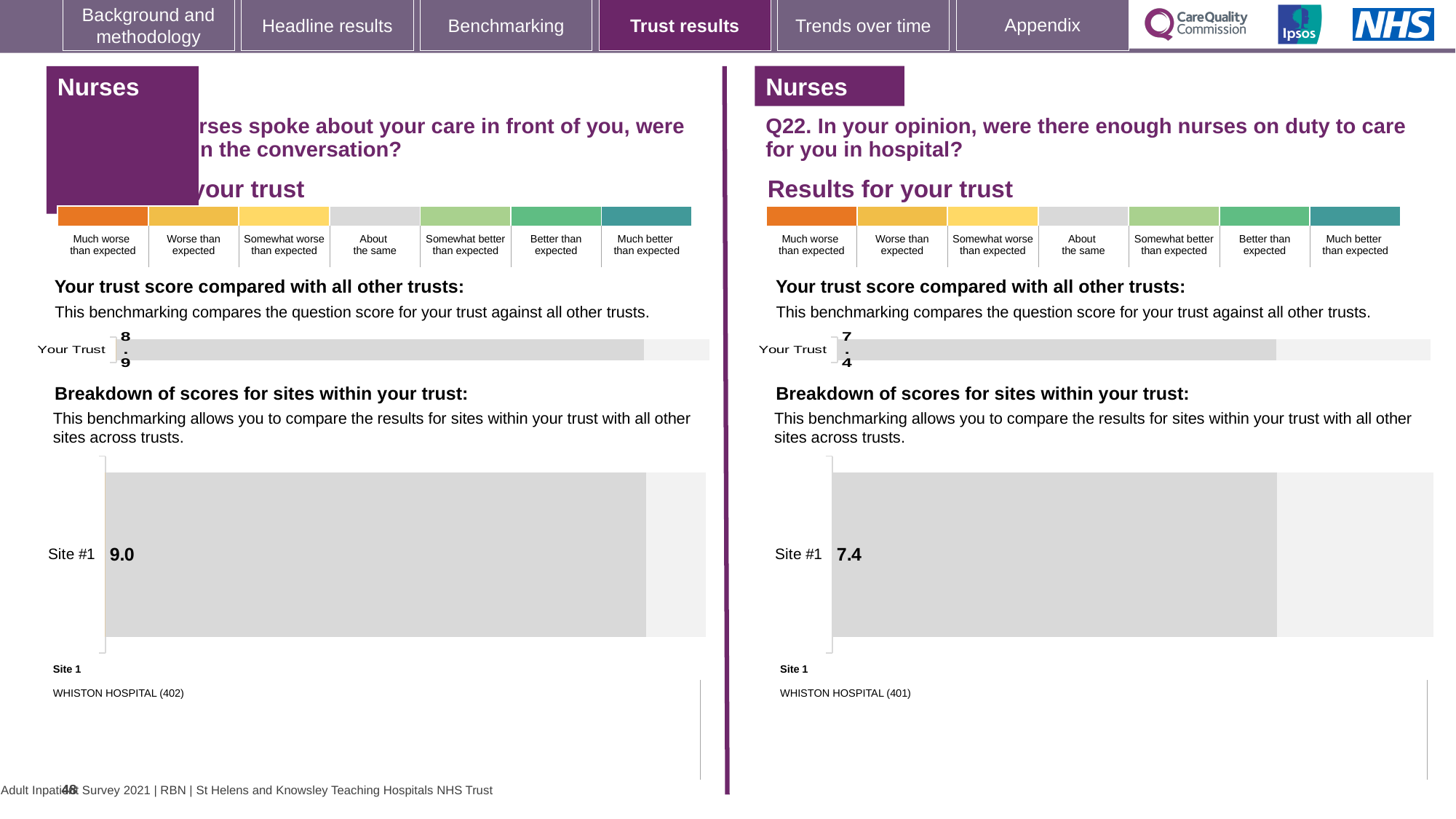
What type of chart is used to show the Site #1 score in the left breakdown chart? Bar chart Which hospital is listed as Site 1 under the right (Q22) breakdown chart? WHISTON HOSPITAL (401) In the right (Q22) 'Breakdown of scores for sites within your trust' chart, what is the score for Site #1? 7.4 Which hospital is listed as Site 1 under the left breakdown chart? WHISTON HOSPITAL (402) What is the difference between the Site #1 score in the left breakdown chart (9.0) and the Site #1 score in the right (Q22) breakdown chart (7.4)? 1.6 Which is larger: the Site #1 score in the left breakdown chart or the Site #1 score in the right (Q22) breakdown chart? The left chart (9.0) On the left half of the slide, what is the score shown for Your Trust in the 'Your trust score compared with all other trusts' chart? 8.9 On the right half of the slide (Q22), what is the score shown for Your Trust in the 'Your trust score compared with all other trusts' chart? 7.4 What is the difference between the Your Trust score on the left (8.9) and the Your Trust score on the right for Q22 (7.4)? 1.5 Is the Your Trust score on the left half of the slide greater or less than the Your Trust score for Q22 on the right? greater How many sites are shown in the right (Q22) 'Breakdown of scores for sites within your trust' chart? 1 In the left 'Breakdown of scores for sites within your trust' chart, what is the score for Site #1? 9.0